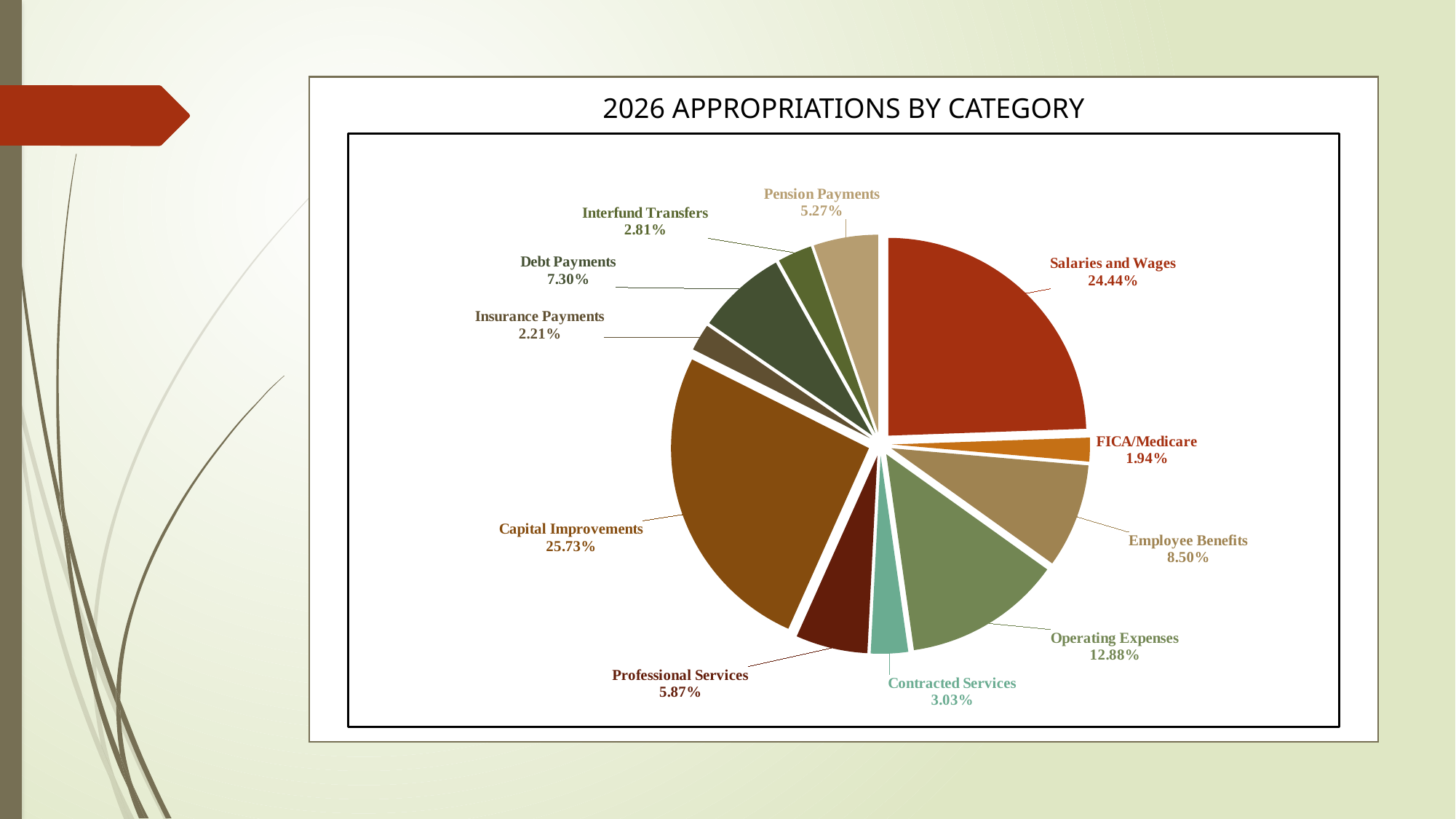
What is the difference between Operating Expenses and Employee Benefits? 4.38% What is the value shown for Operating Expenses? 12.88% What share of the pie does Capital Improvements represent? 25.73% What is the value for Pension Payments? 5.27% Which is larger, Professional Services or Contracted Services? Professional Services How many categories are shown in the pie chart? 11 Which category has the smallest slice of the pie? FICA/Medicare What is the difference in percentage points between Capital Improvements and Salaries and Wages? 1.29% What type of chart is shown on the slide? Pie chart Which category has the largest slice of the pie? Capital Improvements What percentage is labelled for Debt Payments? 7.30% Which is larger, Interfund Transfers or Insurance Payments? Interfund Transfers